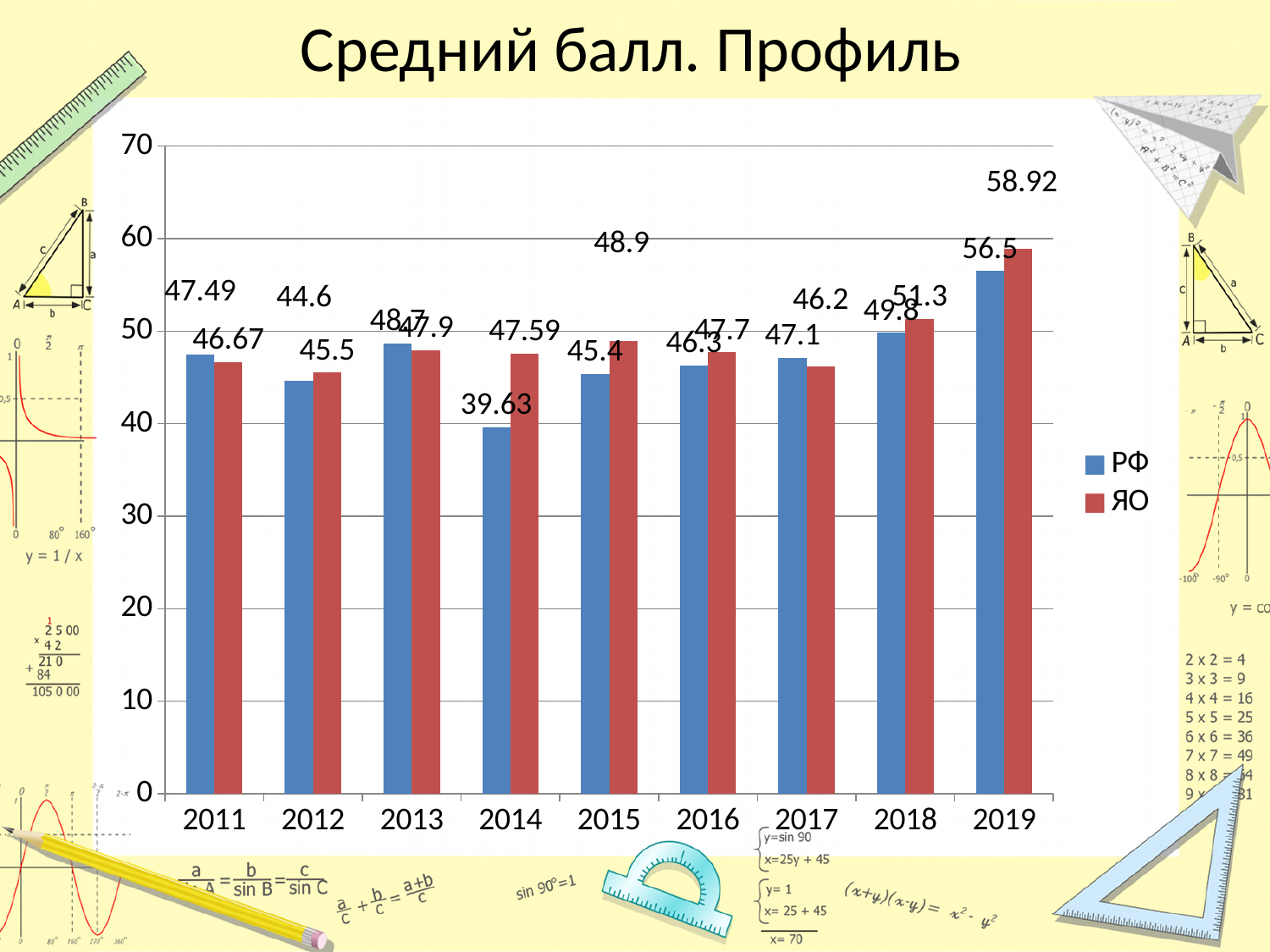
In which year is the РФ value the highest? 2019 In 2017, which series has the larger value, РФ or ЯО? РФ What is the value for ЯО in 2015? 48.9 How many years are shown on the x axis? 9 In which year is the РФ value the lowest? 2014 How many series does the legend list? 2 What is the value for ЯО in 2019? 58.92 What is the difference between the ЯО and РФ values in 2019? 2.42 What type of chart is shown on the slide? Bar chart What is the difference between the ЯО and РФ values in 2014? 7.96 In which year is the ЯО value the highest? 2019 What is the value for РФ in 2014? 39.63